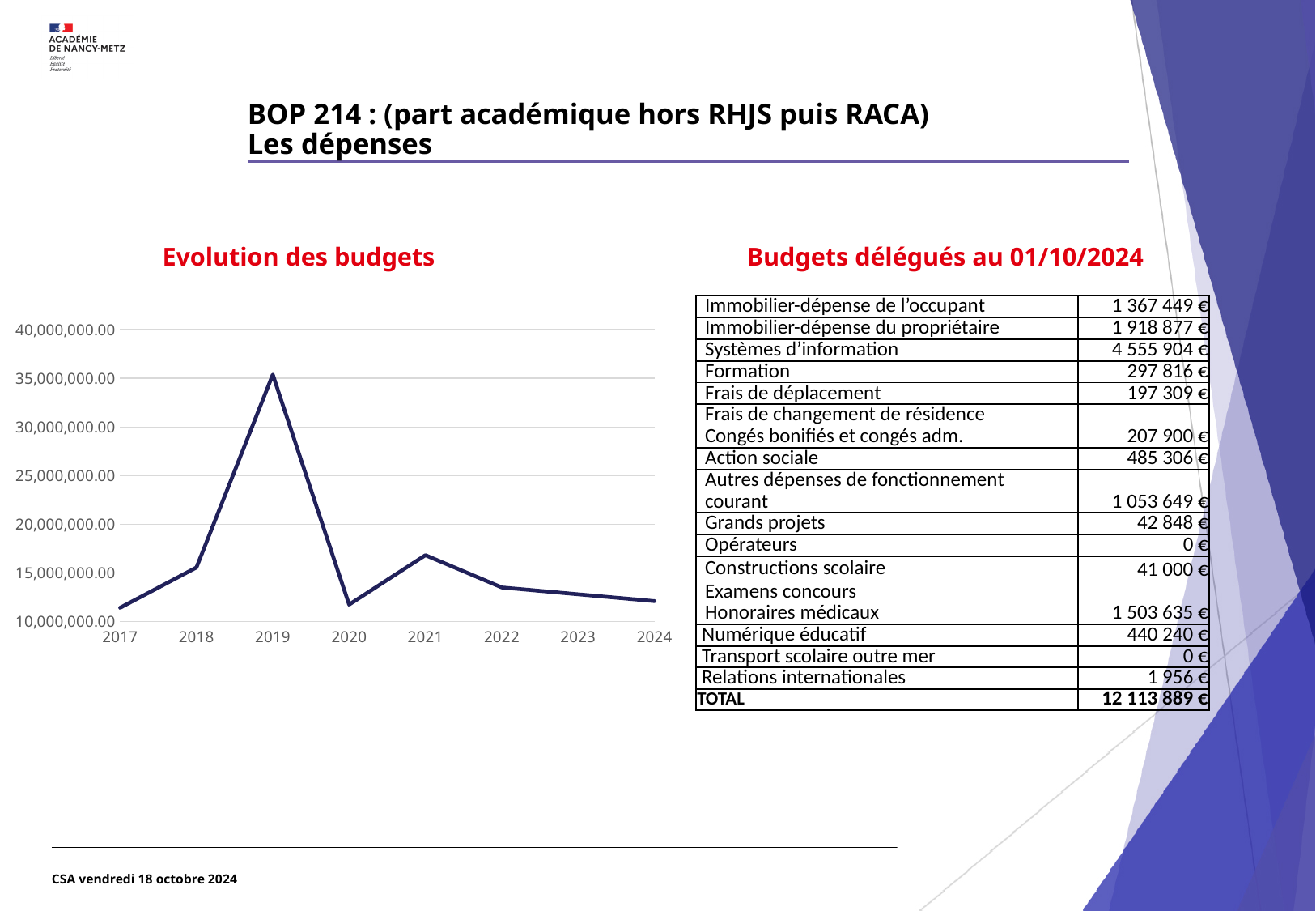
In the "Evolution des budgets" chart, is the value for 2019 greater or less than 30,000,000.00? greater What is the highest value shown on the y axis of the "Evolution des budgets" chart? 40,000,000.00 In the "Evolution des budgets" chart, which is larger, the value for 2018 or the value for 2020? 2018 In the "Evolution des budgets" chart, is the value for 2020 greater or less than 15,000,000.00? less In the "Evolution des budgets" chart, is the value for 2021 greater or less than 20,000,000.00? less In the "Evolution des budgets" chart, do the values rise or fall from 2021 to 2024? fall In the "Evolution des budgets" chart, which year has the highest value? 2019 In the "Evolution des budgets" chart, which is larger, the value for 2019 or the value for 2021? 2019 How many years are plotted on the x axis of the "Evolution des budgets" chart? 8 In the "Evolution des budgets" chart, do the values rise or fall from 2017 to 2019? rise What kind of chart is "Evolution des budgets"? line chart